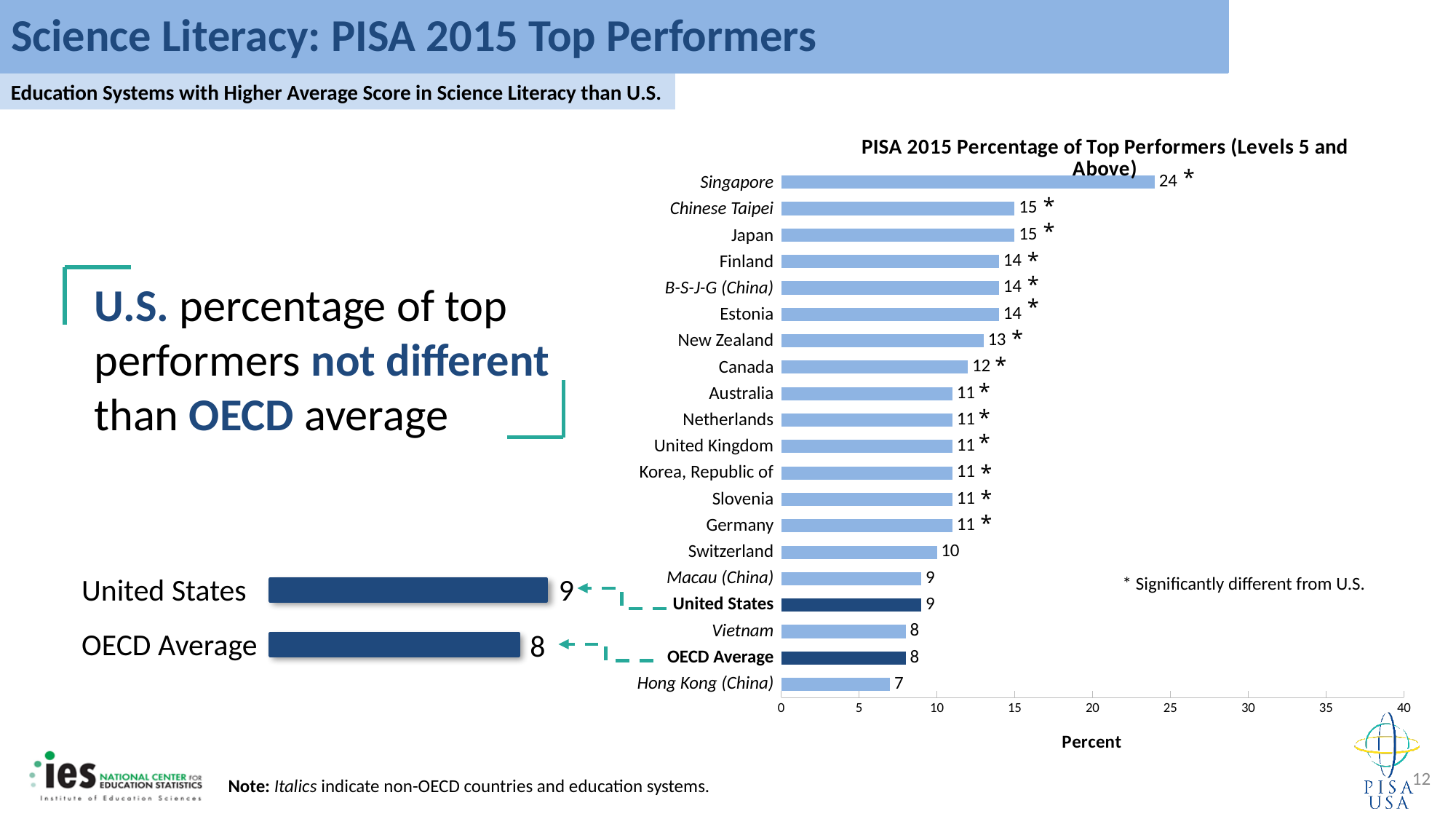
In the chart titled 'PISA 2015 Percentage of Top Performers (Levels 5 and Above)', which education system has the highest percentage? Singapore In the chart titled 'PISA 2015 Percentage of Top Performers (Levels 5 and Above)', what is the value for Canada? 12 In the chart titled 'PISA 2015 Percentage of Top Performers (Levels 5 and Above)', what is the value for Hong Kong (China)? 7 In the chart titled 'PISA 2015 Percentage of Top Performers (Levels 5 and Above)', what is the value for Singapore? 24 In the chart titled 'PISA 2015 Percentage of Top Performers (Levels 5 and Above)', how many education systems (bars) are shown? 20 In the small chart on the left of the slide, what is the difference between United States and OECD Average? 1 In the chart titled 'PISA 2015 Percentage of Top Performers (Levels 5 and Above)', which education system has the lowest percentage? Hong Kong (China) In the chart titled 'PISA 2015 Percentage of Top Performers (Levels 5 and Above)', what is the label of the horizontal axis? Percent In the chart titled 'PISA 2015 Percentage of Top Performers (Levels 5 and Above)', what is the difference between Singapore and Japan? 9 What kind of chart is the chart titled 'PISA 2015 Percentage of Top Performers (Levels 5 and Above)'? Bar chart In the chart titled 'PISA 2015 Percentage of Top Performers (Levels 5 and Above)', which is larger, the value for Finland or the value for New Zealand? Finland In the small chart on the left of the slide, what is the value for United States? 9